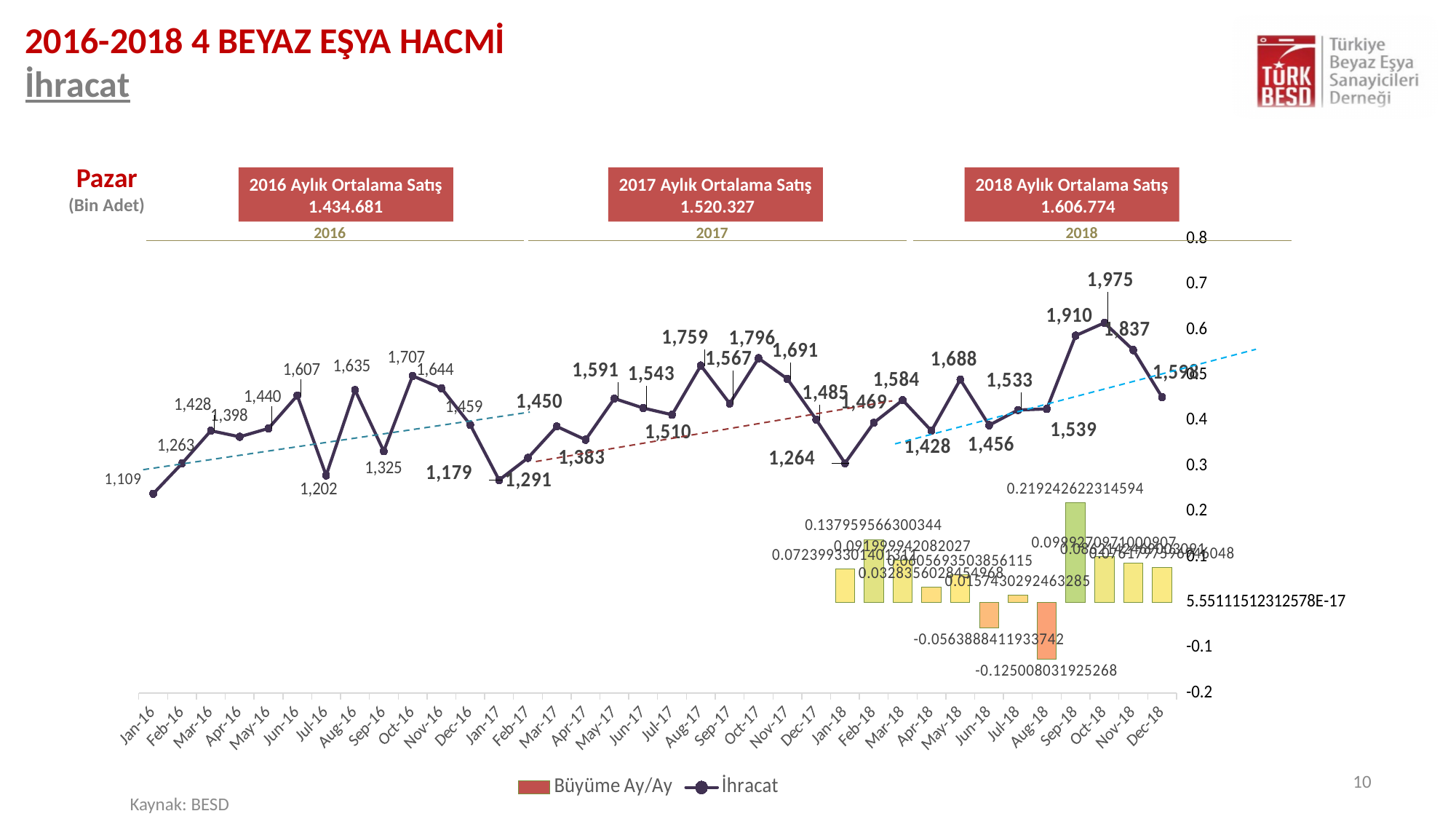
How many monthly points are plotted on the İhracat line? 36 What is the Büyüme Ay/Ay value for Sep-18? 0.219242622314594 What is the difference between the İhracat values for Oct-18 and Sep-18? 65 Which is larger, the İhracat value for Oct-17 or for Aug-17? Oct-17 What is the 2017 Aylık Ortalama Satış shown in the box above the chart? 1.520.327 What is the İhracat value for Jul-16? 1,202 What is the İhracat value for Oct-16? 1,707 How many series does the legend list? 2 What kind of chart is shown? Combined line and bar chart Which month has the highest İhracat value on the line? Oct-18 Which month has the lowest İhracat value on the line? Jan-16 What is the İhracat value for Aug-17? 1,759